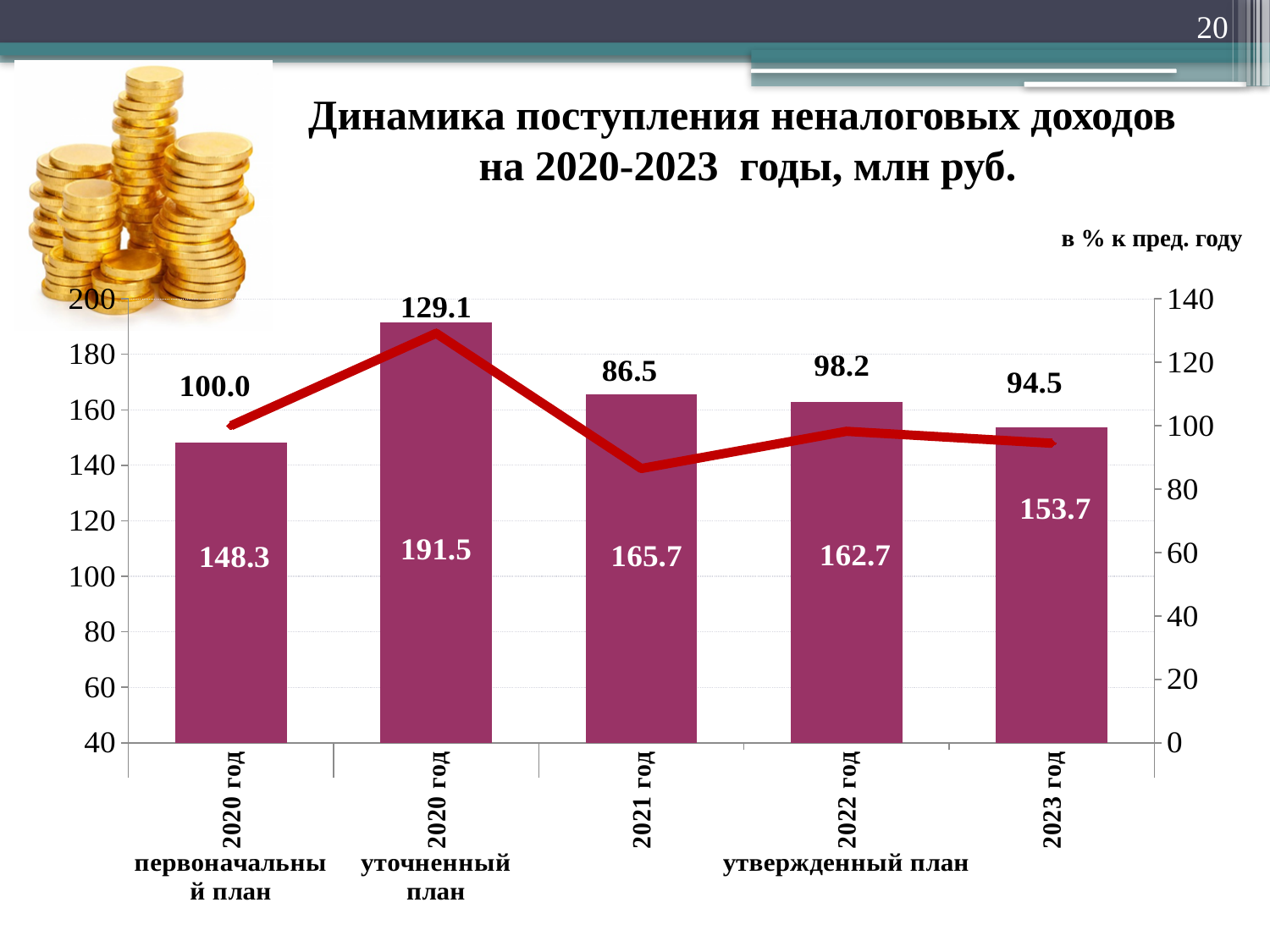
What is the difference between the bar values for 2020 год уточненный план and 2020 год первоначальный план? 43.2 How many bars are plotted in the chart? 5 What is the title of the chart? Динамика поступления неналоговых доходов на 2020-2023 годы, млн руб. Which category has the lowest line value (в % к пред. году)? 2021 год What is the bar value (млн руб.) for 2020 год, уточненный план? 191.5 What is the bar value (млн руб.) for 2023 год? 153.7 Which category has the lowest bar value? 2020 год, первоначальный план What is the line value (в % к пред. году) for 2021 год? 86.5 Which category has the highest bar value? 2020 год, уточненный план Do the bar values rise or fall from 2021 год to 2023 год? fall What is the line value (в % к пред. году) for 2022 год? 98.2 Which is larger: the bar value for 2021 год or for 2022 год? 2021 год